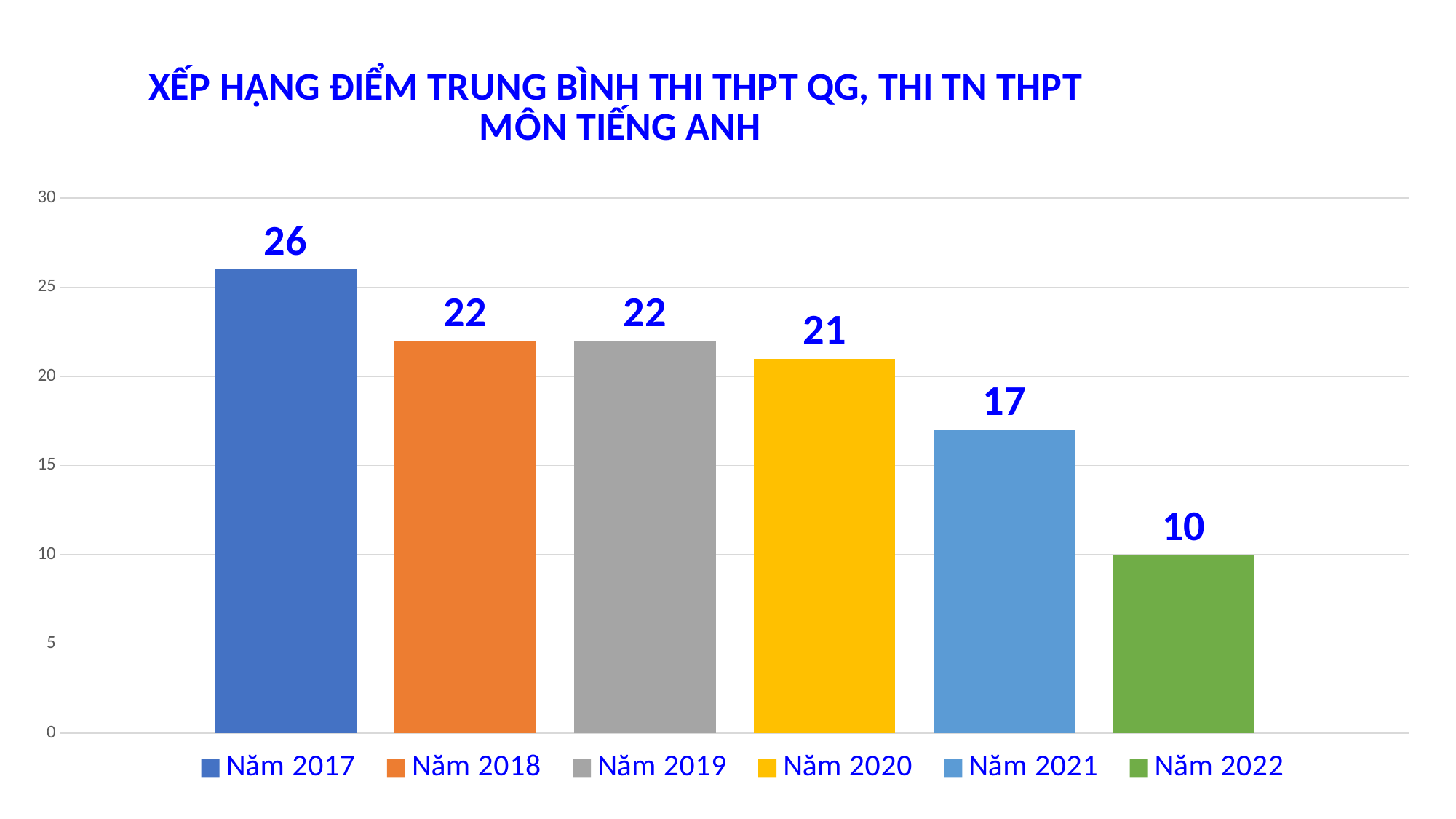
What is the value for Năm 2017? 26 Is the value for Năm 2018 greater or less than 20? greater What is the value for Năm 2022? 10 Which year has the highest value? Năm 2017 Do the values rise or fall from Năm 2017 to Năm 2022? fall What is the difference between the values for Năm 2017 and Năm 2022? 16 What is the value for Năm 2020? 21 How many years are shown in the chart? 6 What is the value for Năm 2021? 17 What kind of chart is shown on the slide? bar chart Which is larger, the value for Năm 2020 or the value for Năm 2021? Năm 2020 Which year has the lowest value? Năm 2022